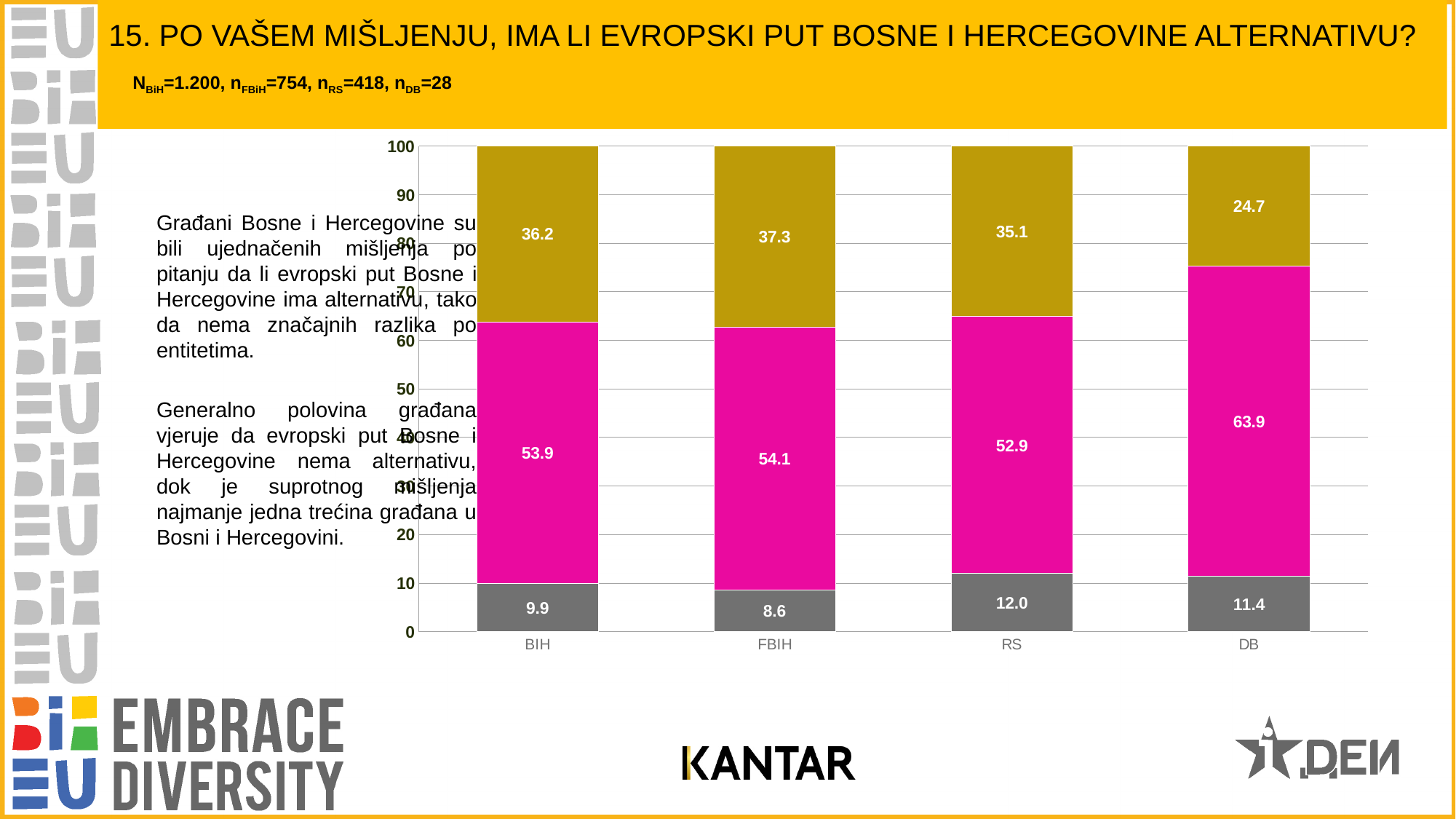
What is the value of the gold (top) segment for RS? 35.1 Is the gold (top) segment value larger for FBIH or for RS? FBIH Which category has the highest value for the grey (bottom) segment? RS Which category has the lowest value for the gold (top) segment? DB What are the category labels on the x axis, from left to right? BIH, FBIH, RS, DB How many categories are shown on the x axis of the chart? 4 What type of chart is shown on the slide? Stacked bar chart Which category has the highest value for the magenta (middle) segment? DB What is the total of the stacked bar for RS? 100.0 What is the difference between the magenta segment values for DB and BIH? 10.0 What is the value of the grey (bottom) segment for FBIH? 8.6 What is the value of the magenta (middle) segment for DB? 63.9